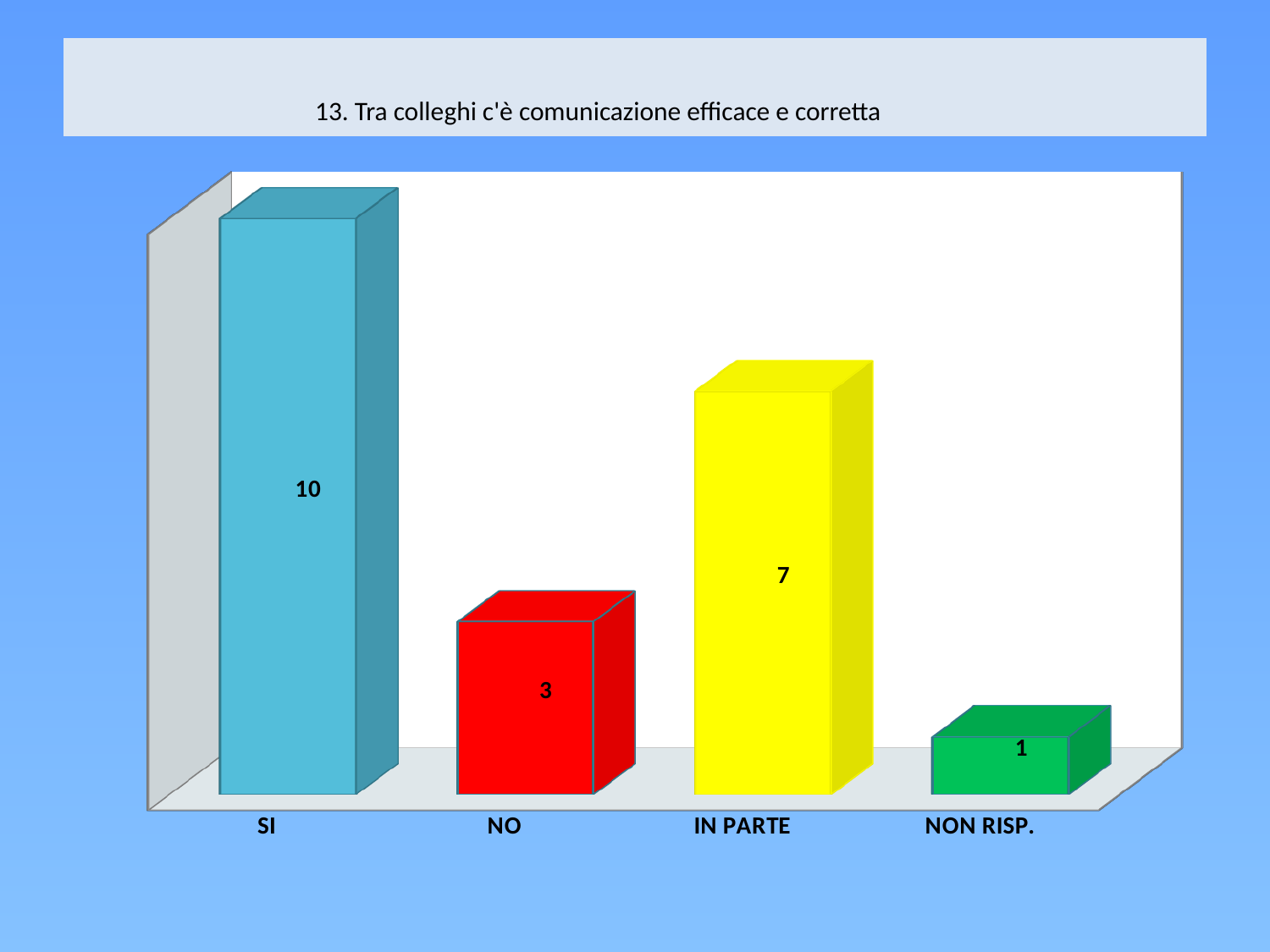
Which category has the highest value? SI What is the value for IN PARTE? 7 What is the difference between the values for SI and IN PARTE? 3 What is the difference between the values for NO and NON RISP.? 2 How many categories are shown on the x axis? 4 Which is larger, the value for NO or the value for IN PARTE? IN PARTE What kind of chart is shown on the slide? bar chart What is the title of the slide? 13. Tra colleghi c'è comunicazione efficace e corretta What is the value for SI? 10 Which category has the lowest value? NON RISP. What is the value for NO? 3 What is the value for NON RISP.? 1